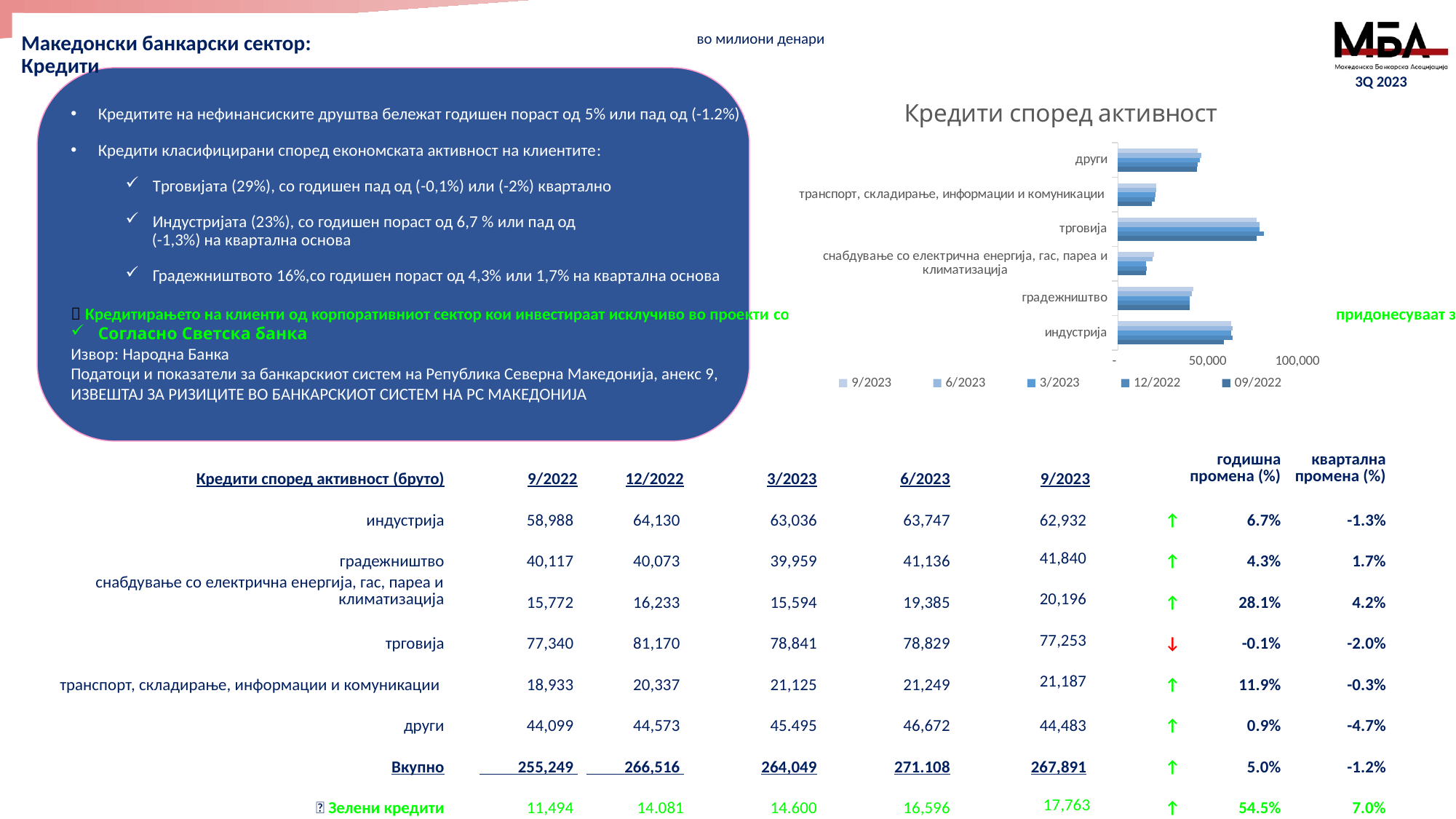
How many categories (economic activities) are shown on the "Кредити според активност" chart? 6 On the "Кредити според активност" chart, is the value for транспорт, складирање, информации и комуникации in 9/2023 greater or less than 50,000? less How many series does the legend of the "Кредити според активност" chart list? 5 Which category has the highest values on the "Кредити според активност" chart? трговија What type of chart is shown under the title "Кредити според активност"? bar chart What is the value for трговија in 9/2022, as printed in the table below the chart? 77,340 What is the value for индустрија in 9/2023 (in millions of denars), as printed in the table below the chart? 62,932 On the "Кредити според активност" chart, is the value for градежништво in 9/2023 greater or less than 50,000? less On the "Кредити според активност" chart, is the value for трговија in 9/2023 greater or less than 50,000? greater What is the difference between трговија and индустрија in 9/2023, using the values printed in the table? 14,321 What is the title of the chart on the slide? Кредити според активност Which is larger on the "Кредити според активност" chart for 9/2023: трговија or индустрија? трговија